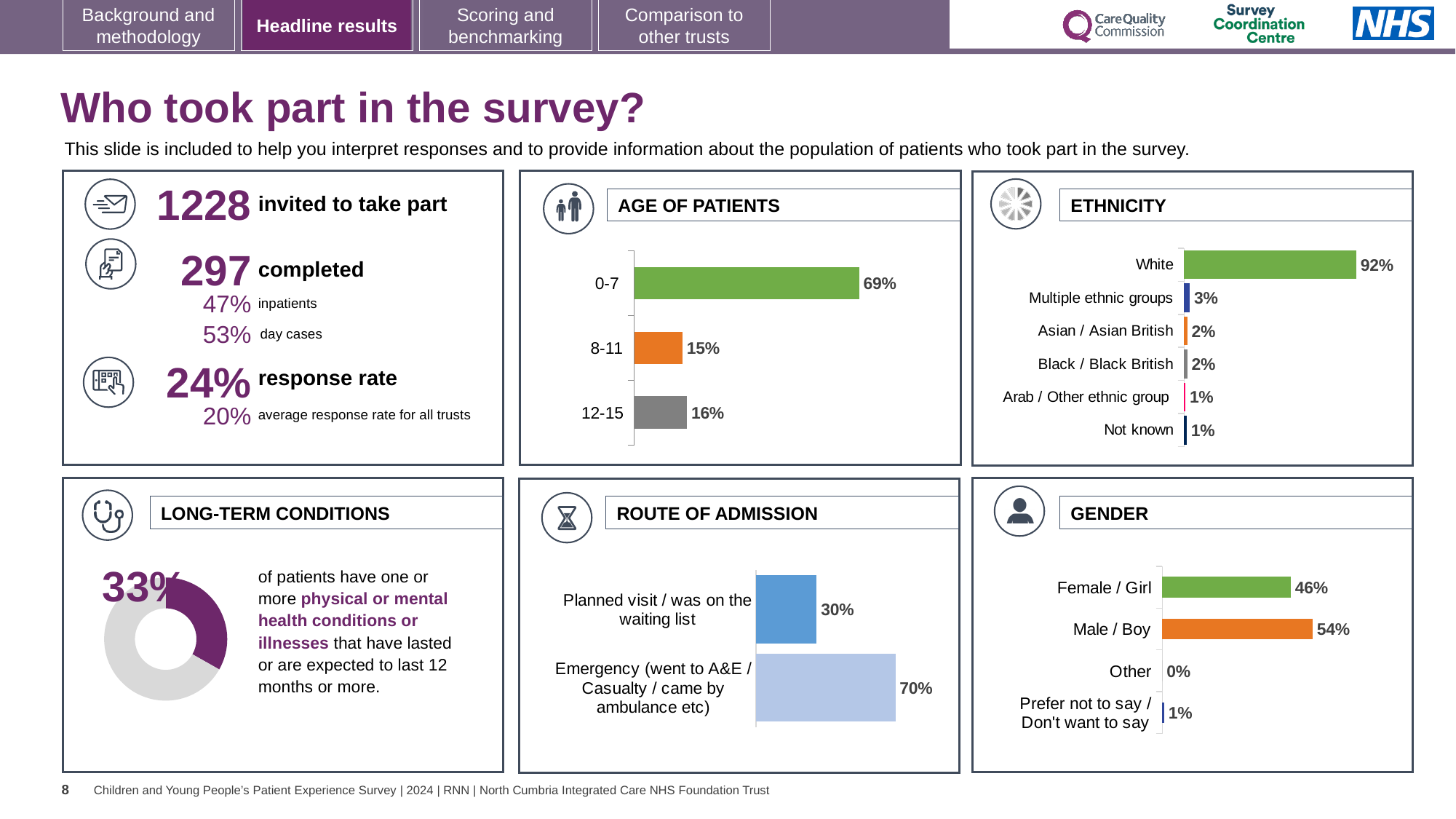
In the AGE OF PATIENTS chart, which age group has the lowest percentage? 8-11 What kind of chart is used in the LONG-TERM CONDITIONS panel? Donut (pie) chart In the ETHNICITY chart, how many ethnicity categories are listed? 6 In the GENDER chart, what percentage answered Prefer not to say / Don't want to say? 1% In the ETHNICITY chart, what percentage of patients were White? 92% In the AGE OF PATIENTS chart, how many age groups are shown? 3 In the AGE OF PATIENTS chart, what percentage of patients were aged 0-7? 69% In the ROUTE OF ADMISSION chart, what is the difference between the Emergency and Planned visit percentages? 40% In the GENDER chart, which category has the highest percentage? Male / Boy In the GENDER chart, which is larger: Female / Girl or Male / Boy? Male / Boy In the ROUTE OF ADMISSION chart, what percentage of patients came via Emergency? 70% In the ETHNICITY chart, what is the difference between the White and Multiple ethnic groups percentages? 89%